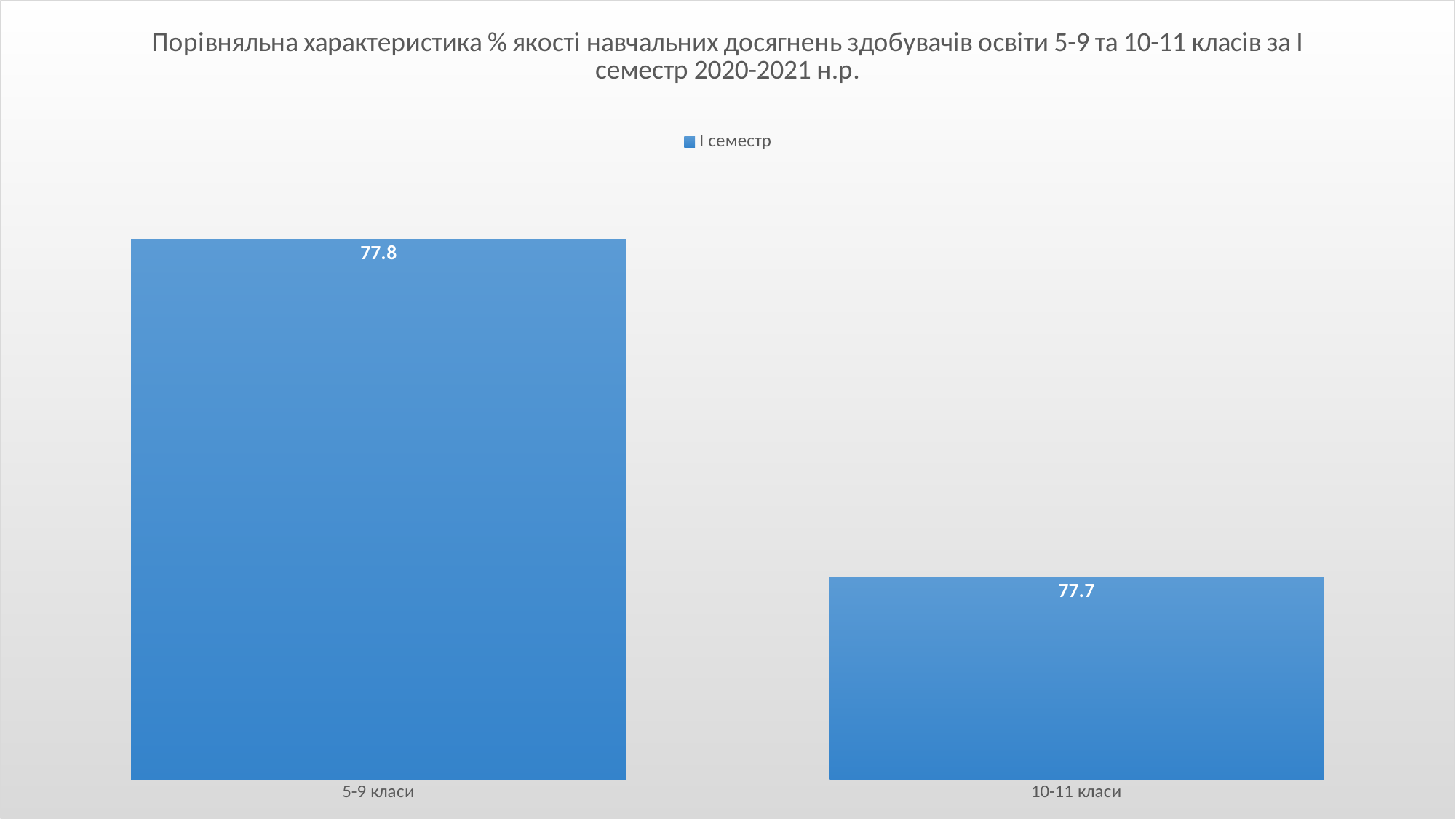
What colour are the bars on the chart? blue How many categories are shown on the chart? 2 Which category has the lowest value? 10-11 класи What is the value for 10-11 класи? 77.7 What kind of chart is shown on the slide? bar chart Which category has the highest value? 5-9 класи What is the value for 5-9 класи? 77.8 What series name is shown in the legend? І семестр Which is larger, the value for 5-9 класи or the value for 10-11 класи? 5-9 класи What is the difference between the values for 5-9 класи and 10-11 класи? 0.1 Do the values rise or fall from 5-9 класи to 10-11 класи? fall How many series does the legend list? 1